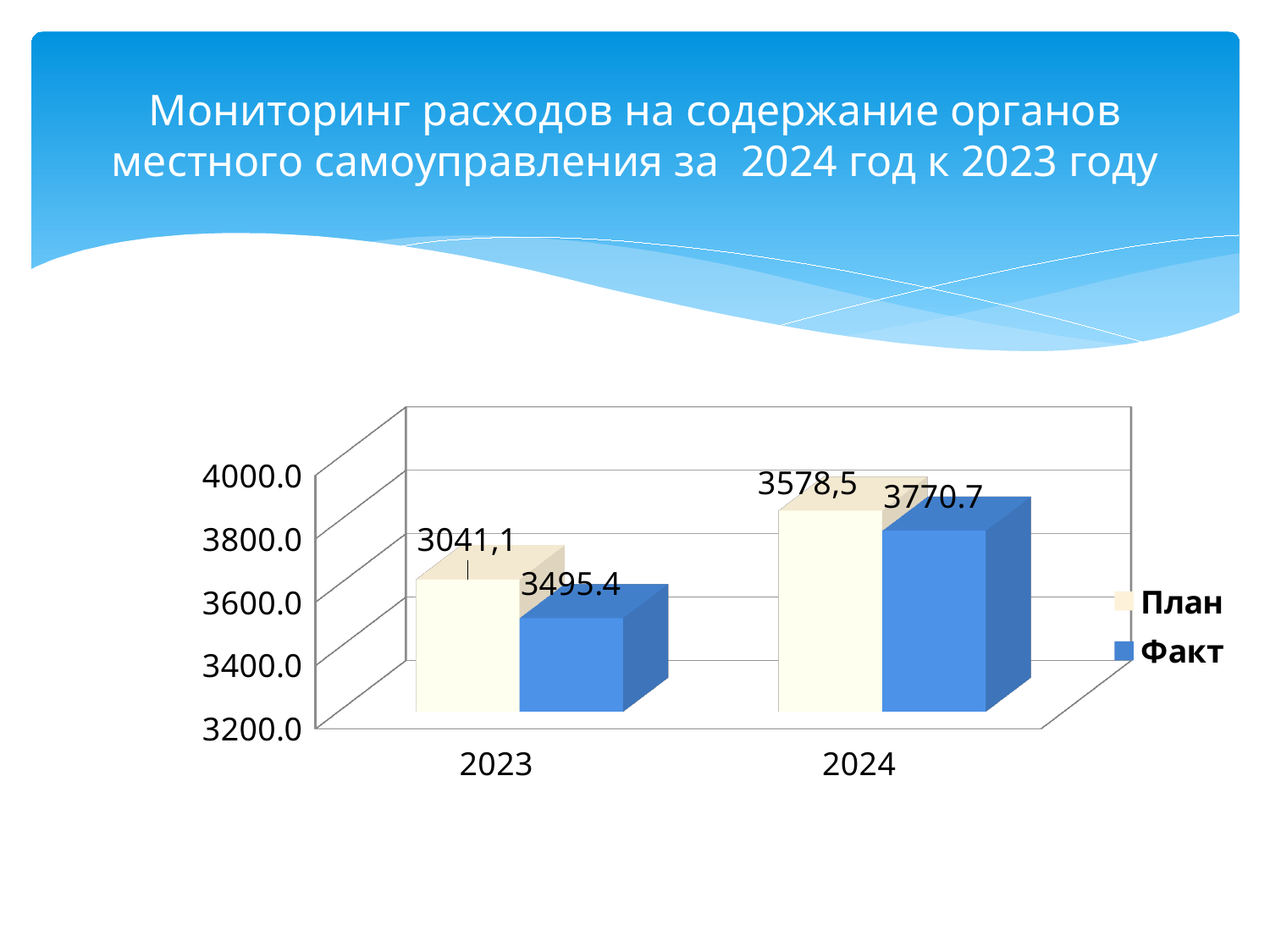
What is the value of Факт for 2024? 3770.7 Is the Факт value for 2024 greater or less than 3600? greater What data label is shown on the План bar for 2023? 3041,1 What are the two entries in the chart legend? План and Факт For 2024, which is larger, План or Факт? План Does the Факт value rise or fall from 2023 to 2024? rise Which year has the higher Факт value? 2024 How many years are shown on the x axis? 2 How many series does the legend list? 2 What is the value of Факт for 2023? 3495.4 What kind of chart is shown on the slide? bar chart